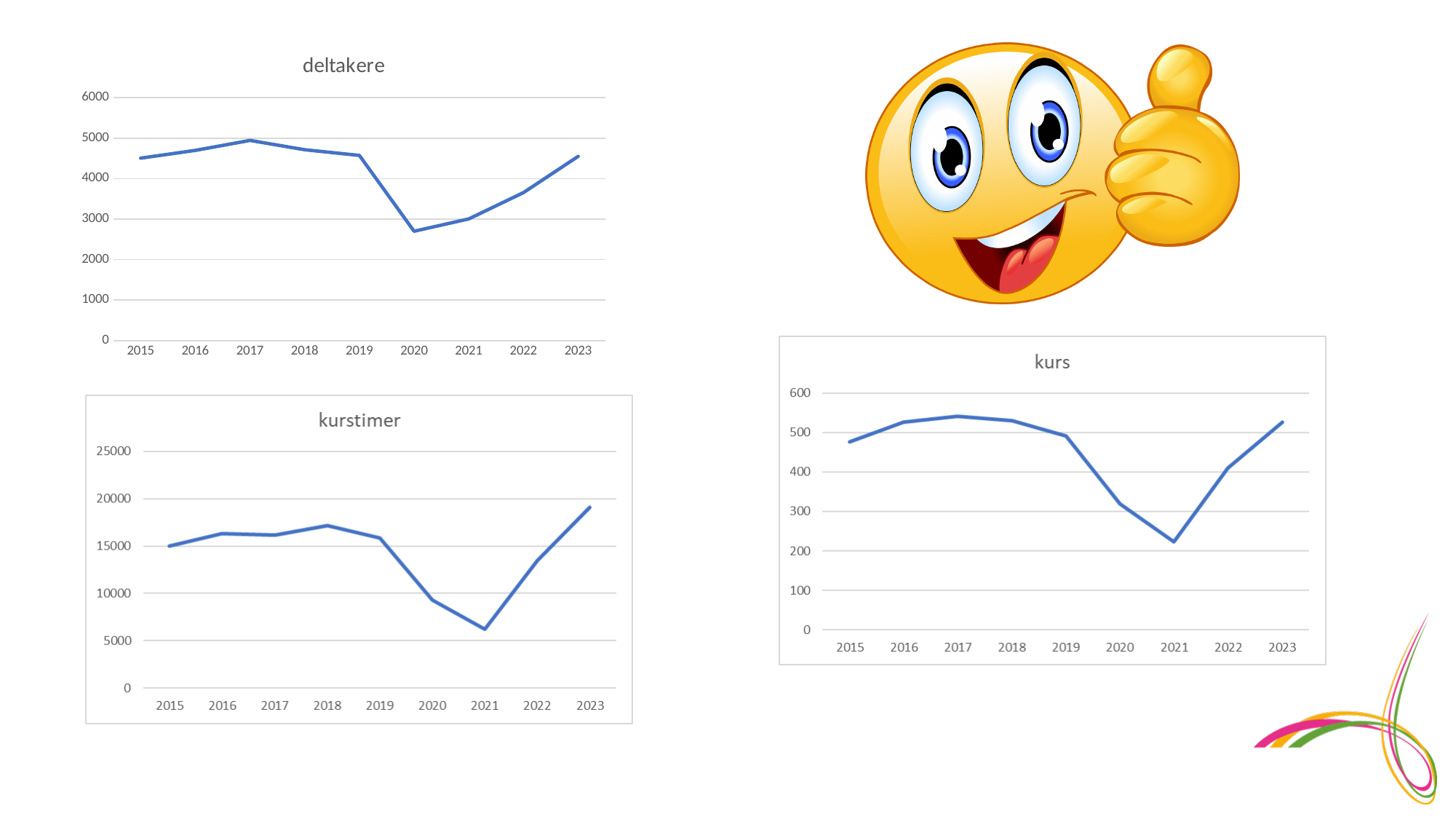
In the "deltakere" chart, is the value for 2020 greater or less than 3000? less In the "kurstimer" chart, which year has the larger value, 2015 or 2023? 2023 In the "kurstimer" chart, is the value for 2021 greater or less than 5000? greater In the "kurs" chart, which year has the lowest value? 2021 In the "deltakere" chart, which year has the highest value? 2017 In the "kurstimer" chart, which year has the highest value? 2023 How many years are shown on the x axis of the "kurstimer" chart? 9 In the "deltakere" chart, do the values rise or fall from 2020 to 2023? rise In the "deltakere" chart, which year has the lowest value? 2020 In the "kurstimer" chart, which year has the lowest value? 2021 In the "kurs" chart, is the value for 2023 greater or less than 500? greater What kind of chart is the "deltakere" chart? line chart